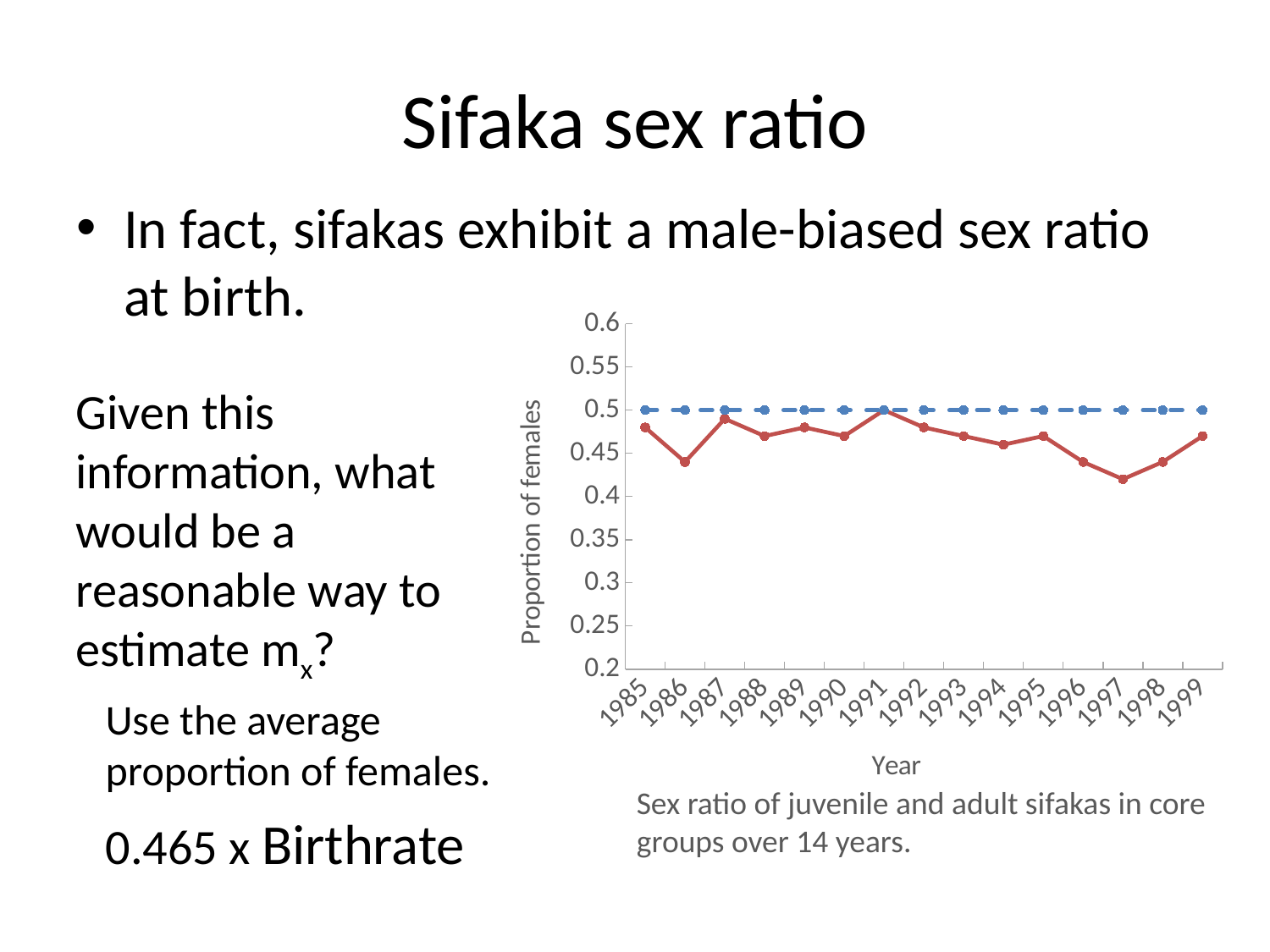
Is the proportion of females for 1997 greater or less than 0.45? less In which year is the proportion of females on the red line lowest? 1997 Is the proportion of females for 1988 greater or less than 0.45? greater What is the proportion of females for 1991 on the red line? 0.5 How many years are plotted along the x axis of the chart? 15 In which year is the proportion of females on the red line highest? 1991 What kind of chart is shown on the slide? line chart Does the red line rise or fall between 1991 and 1997? fall Which year has a higher proportion of females on the red line, 1986 or 1988? 1988 At what value does the blue dashed reference line sit on the chart? 0.5 What is the title of the y axis of the chart? Proportion of females Is the proportion of females for 1985 greater or less than 0.5? less